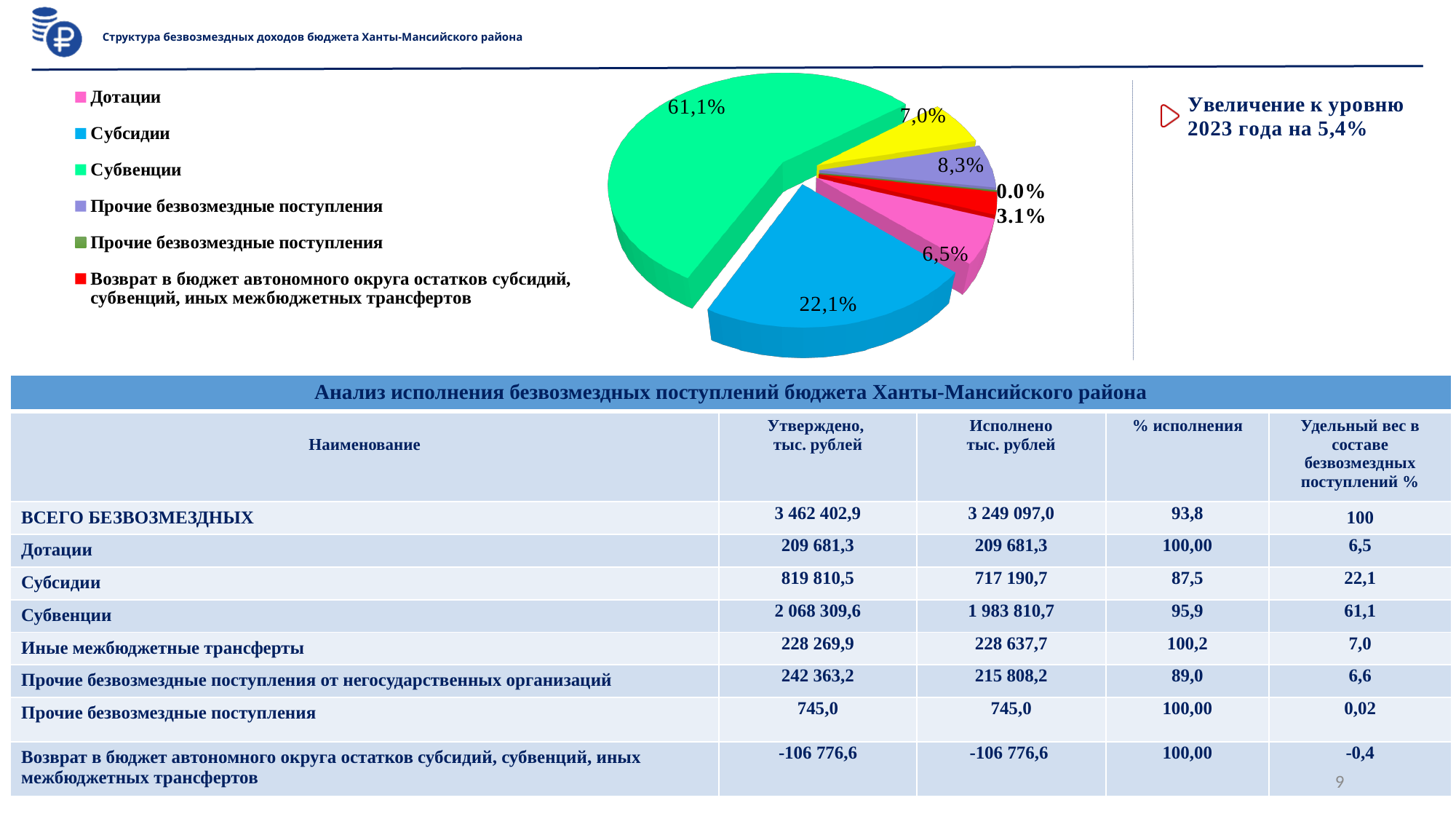
What kind of chart is shown on the slide? pie chart Which slice is larger in the pie chart, Субсидии or Дотации? Субсидии Which category has the largest slice in the pie chart? Субвенции What share of the pie chart does Субвенции account for? 61,1% What share of the pie chart does Дотации account for? 6,5% By how many percentage points does the Субвенции slice exceed the Субсидии slice? 39,0 How many entries does the pie chart's legend list? 6 How many percentage labels are shown on the pie chart? 7 What share of the pie chart does Субсидии account for? 22,1% By how many percentage points does the Дотации slice exceed the Возврат в бюджет автономного округа slice? 3,4 What share of the pie chart is labelled for Возврат в бюджет автономного округа остатков субсидий, субвенций, иных межбюджетных трансфертов? 3.1% What colour is the Субвенции slice in the pie chart? green